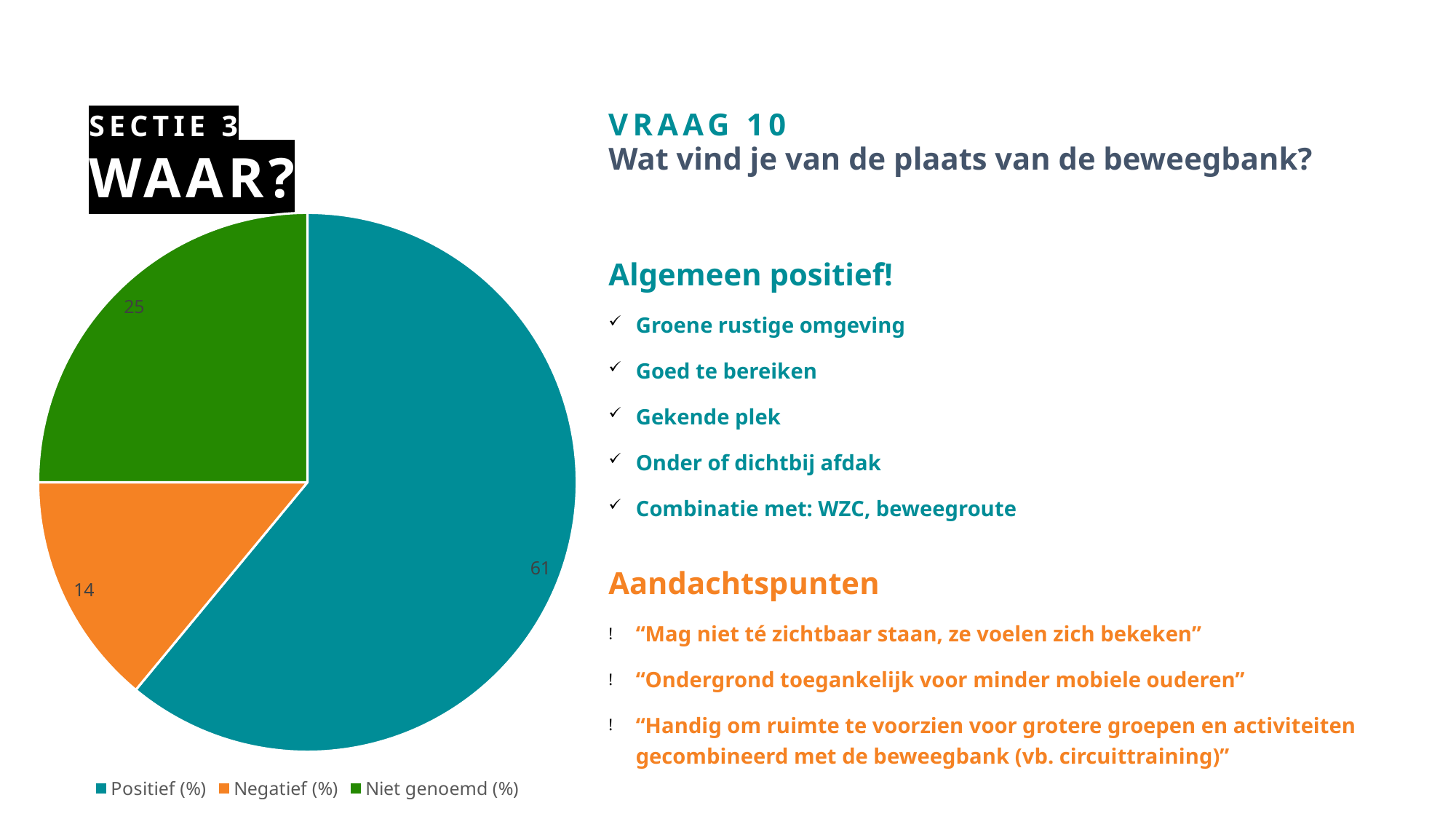
What colour is the Negatief (%) slice in the pie chart? orange What kind of chart is shown on the slide? pie chart Which category has the largest slice in the pie chart? Positief (%) What is the value for Negatief (%) in the pie chart? 14 What is the difference between the values for Niet genoemd (%) and Negatief (%)? 11 How many slices does the pie chart have? 3 What is the value for Niet genoemd (%) in the pie chart? 25 What is the difference between the values for Positief (%) and Negatief (%)? 47 How many entries does the legend list? 3 Which category has the smallest slice in the pie chart? Negatief (%) What is the value for Positief (%) in the pie chart? 61 Which is larger, the value for Niet genoemd (%) or the value for Negatief (%)? Niet genoemd (%)